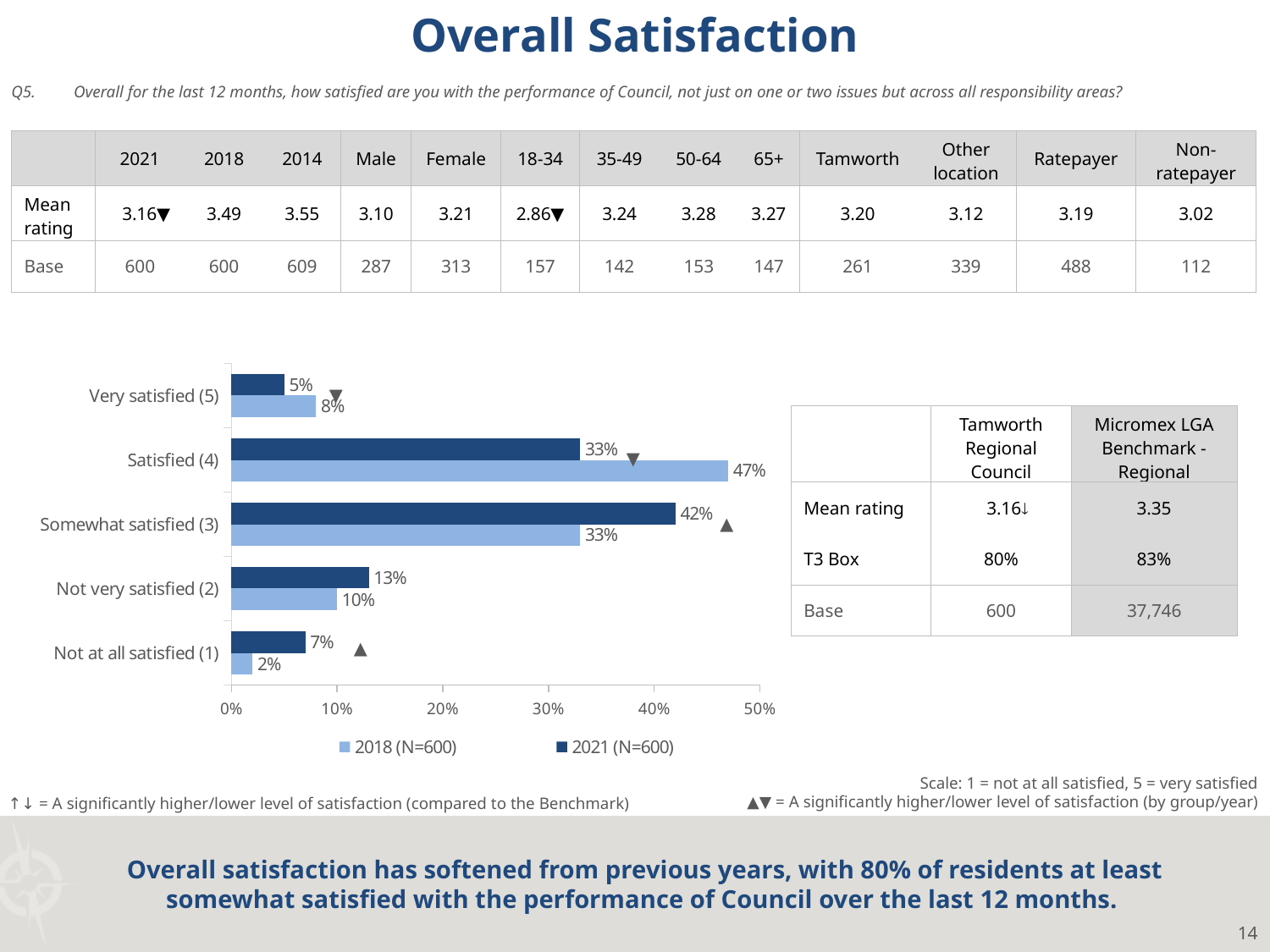
What is the 2021 value for 'Somewhat satisfied (3)'? 42% What percentage of respondents were 'Satisfied (4)' in 2018? 47% How many series does the chart legend list? 2 Is the 2018 value for 'Satisfied (4)' greater or less than 40%? greater How many satisfaction categories are shown on the chart? 5 What type of chart is shown on the slide? Bar chart What is the 2018 value for 'Not at all satisfied (1)'? 2% Which is larger for 'Not very satisfied (2)': the 2018 value or the 2021 value? 2021 Which category has the lowest value for the 2018 series? Not at all satisfied (1) What percentage of respondents were 'Satisfied (4)' in 2021? 33% What is the difference between the 2018 and 2021 values for 'Satisfied (4)'? 14% Which category has the highest value for the 2021 series? Somewhat satisfied (3)